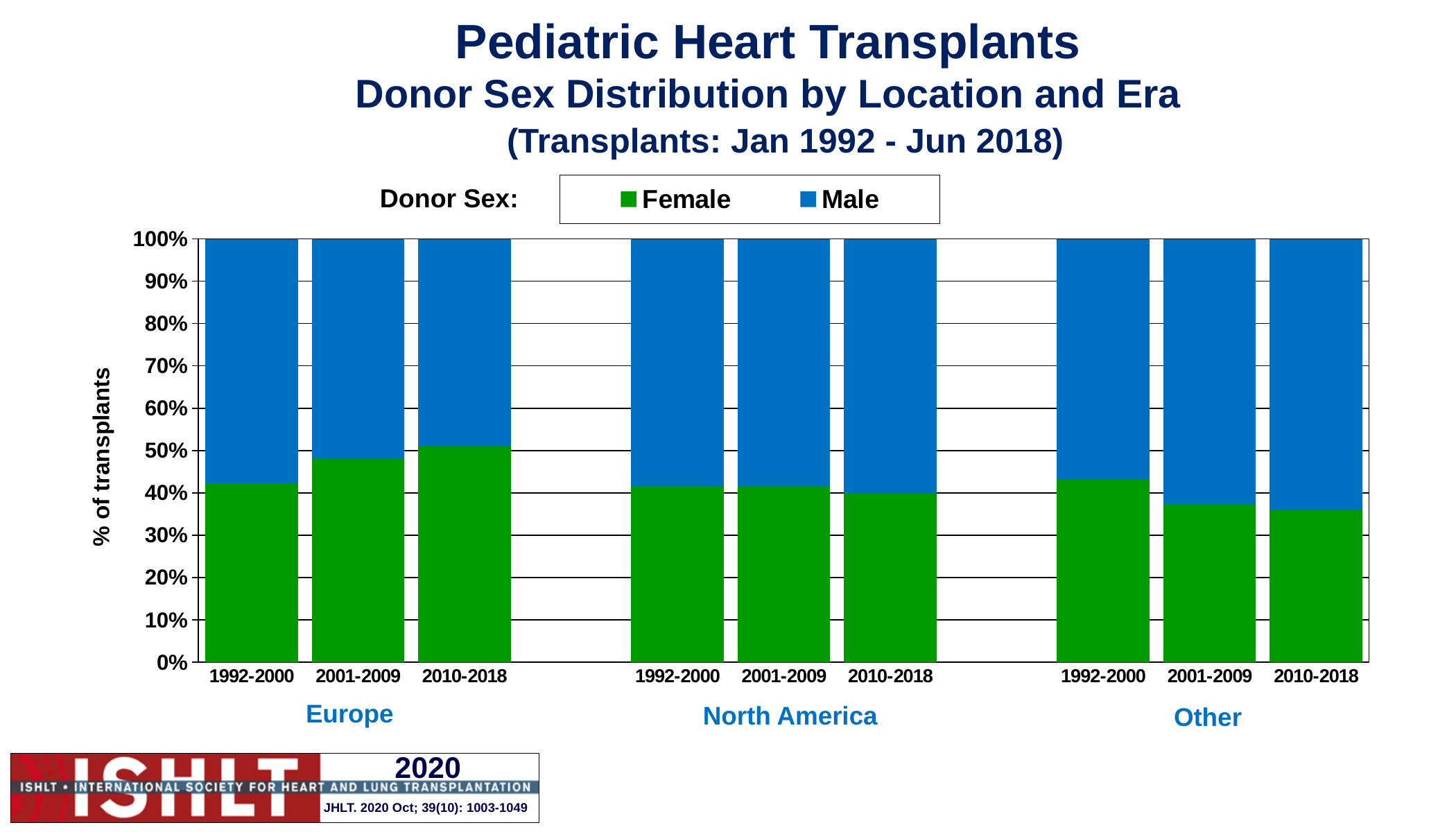
Does the Female share in the Other group rise or fall across the eras from 1992-2000 to 2010-2018? fall How many series does the legend list? 2 Which colour represents Female donors in the chart? Green Is the Female share for Europe 1992-2000 greater or less than 40%? greater Which bar has the highest Female share of transplants? Europe 2010-2018 How many bars are plotted in the chart? 9 Does the Female share in Europe rise or fall across the eras from 1992-2000 to 2010-2018? rise Is the Female share for Other 2010-2018 greater or less than 40%? less How many location groups are shown along the x axis? 3 What kind of chart is shown on the slide? Stacked bar chart Is the Female share for Europe 2001-2009 greater or less than 50%? less Which has the larger Female share: Europe 2010-2018 or North America 2010-2018? Europe 2010-2018